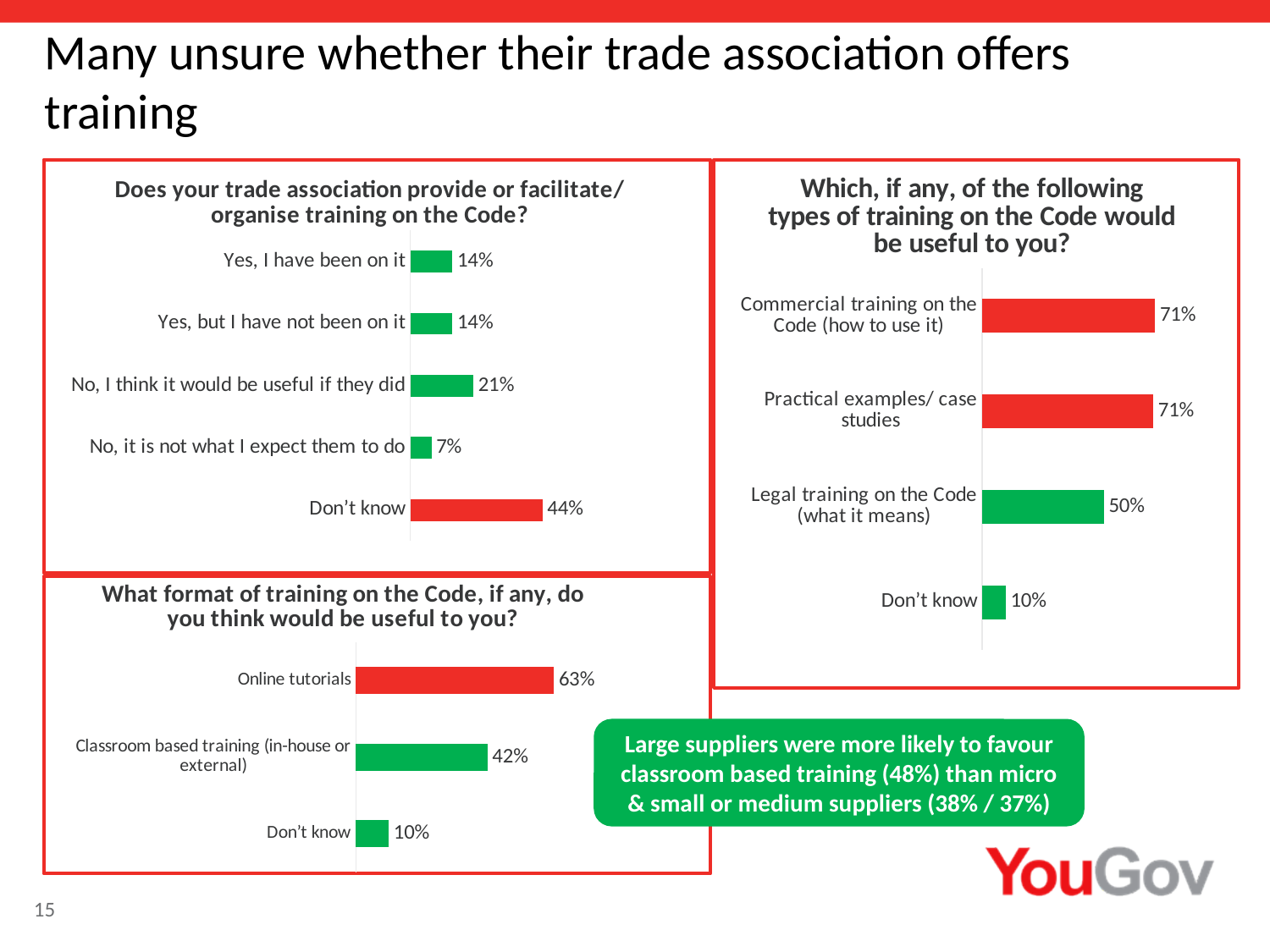
In the chart titled "Which, if any, of the following types of training on the Code would be useful to you?", what is the value for "Legal training on the Code (what it means)"? 50% How many categories are shown in the chart titled "What format of training on the Code, if any, do you think would be useful to you?"? 3 How many categories are shown in the chart titled "Does your trade association provide or facilitate/organise training on the Code?"? 5 In the chart titled "What format of training on the Code, if any, do you think would be useful to you?", what is the value for "Online tutorials"? 63% In the chart titled "Which, if any, of the following types of training on the Code would be useful to you?", what is the difference between "Commercial training on the Code (how to use it)" and "Legal training on the Code (what it means)"? 21 percentage points In the chart titled "What format of training on the Code, if any, do you think would be useful to you?", which is larger: "Online tutorials" or "Classroom based training (in-house or external)"? Online tutorials In the chart titled "Does your trade association provide or facilitate/organise training on the Code?", what is the difference between "Don't know" and "No, I think it would be useful if they did"? 23 percentage points In the chart titled "Which, if any, of the following types of training on the Code would be useful to you?", which category has the lowest value? Don't know In the chart titled "Does your trade association provide or facilitate/organise training on the Code?", what colour is the bar for "Don't know"? Red What type of chart is the chart titled "What format of training on the Code, if any, do you think would be useful to you?"? Bar chart In the chart titled "Does your trade association provide or facilitate/organise training on the Code?", which category has the lowest value? No, it is not what I expect them to do In the chart titled "Does your trade association provide or facilitate/organise training on the Code?", what is the value for "Don't know"? 44%